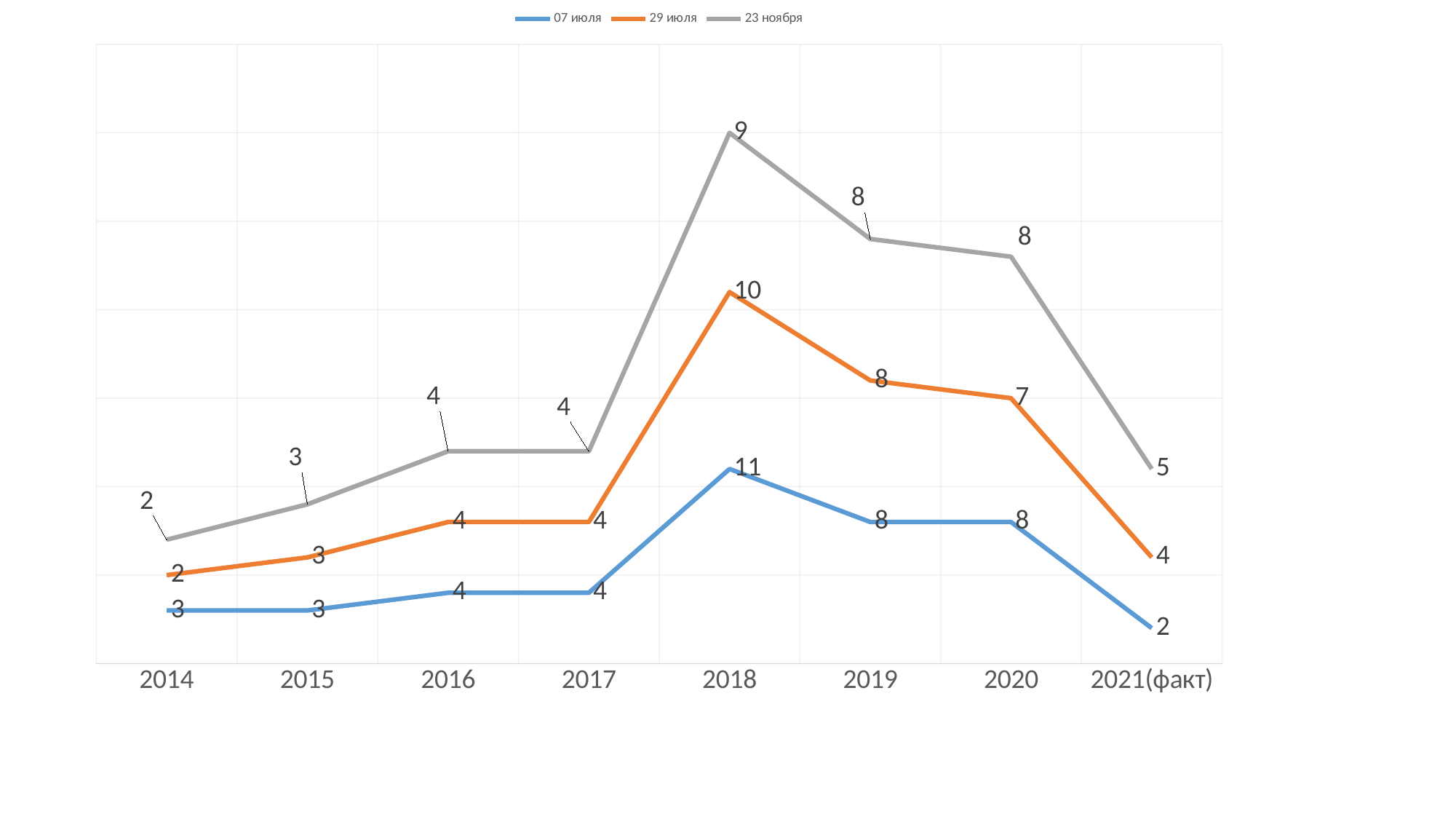
In which category does the 07 июля series have its lowest value? 2021(факт) What type of chart is shown on the slide? line chart What is the value for the 07 июля series in 2018? 11 What is the difference between the 07 июля value in 2018 and its value in 2019? 3 What is the value for the 23 ноября series in 2021(факт)? 5 How many series does the legend list? 3 How many categories are shown on the x axis? 8 In which year does the 23 ноября series reach its highest value? 2018 Which is larger for the 29 июля series: the value in 2018 or the value in 2021(факт)? 2018 Which series is drawn in orange? 29 июля Does the 07 июля series rise or fall from 2020 to 2021(факт)? fall What is the value for the 29 июля series in 2020? 7